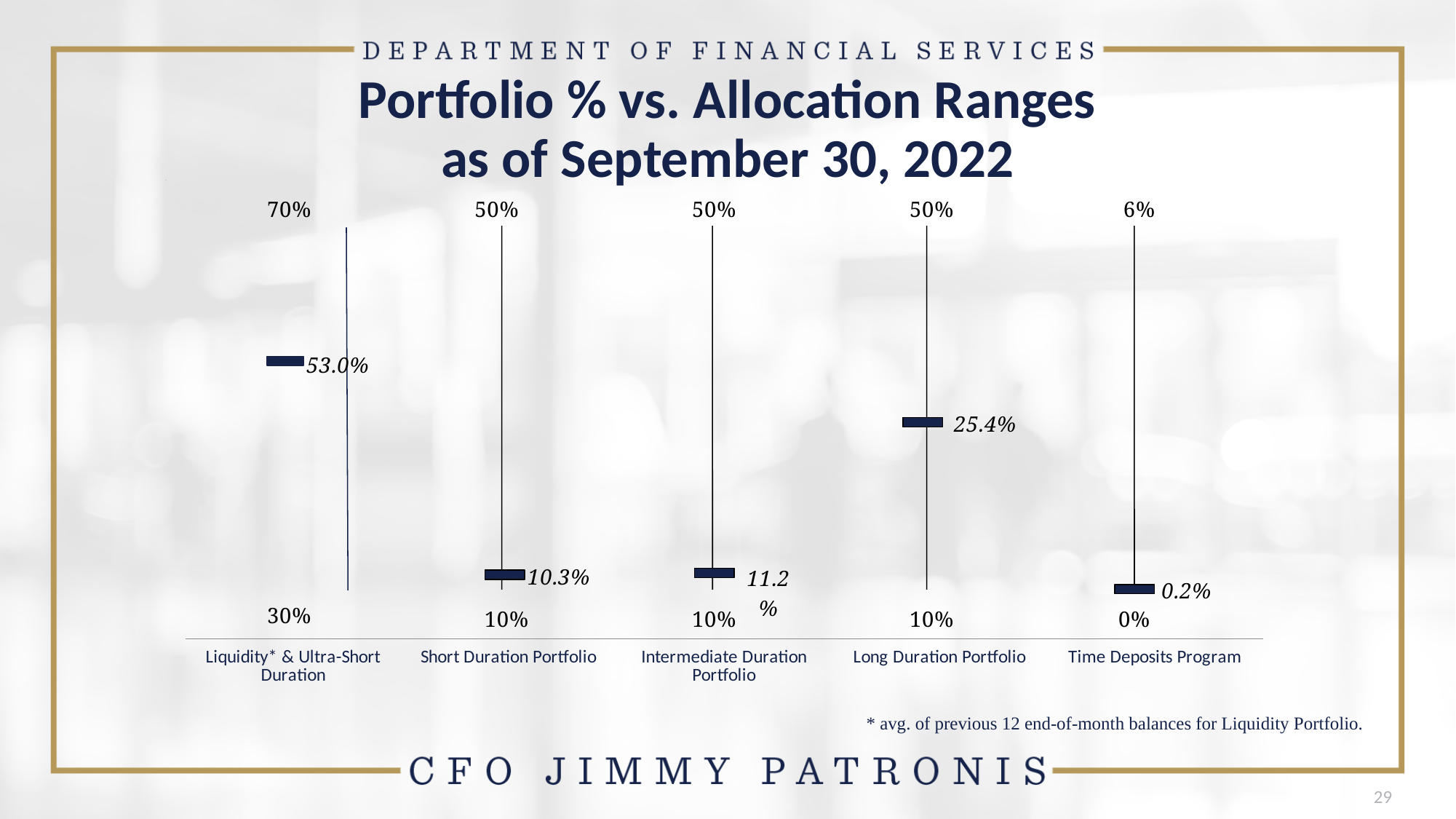
Which has a larger portfolio percentage, the Intermediate Duration Portfolio or the Short Duration Portfolio? Intermediate Duration Portfolio Which category has the highest portfolio percentage? Liquidity* & Ultra-Short Duration What is the portfolio percentage for the Time Deposits Program? 0.2% What is the lower end of the allocation range shown for the Liquidity* & Ultra-Short Duration category? 30% What is the portfolio percentage for the Short Duration Portfolio? 10.3% What is the difference between the portfolio percentages of the Long Duration Portfolio and the Short Duration Portfolio? 15.1% What is the title of the chart? Portfolio % vs. Allocation Ranges as of September 30, 2022 How many categories are shown on the chart? 5 What is the upper end of the allocation range shown for the Time Deposits Program? 6% What is the portfolio percentage for the Long Duration Portfolio? 25.4% What is the portfolio percentage for the Liquidity* & Ultra-Short Duration category? 53.0% Which category has the lowest portfolio percentage? Time Deposits Program